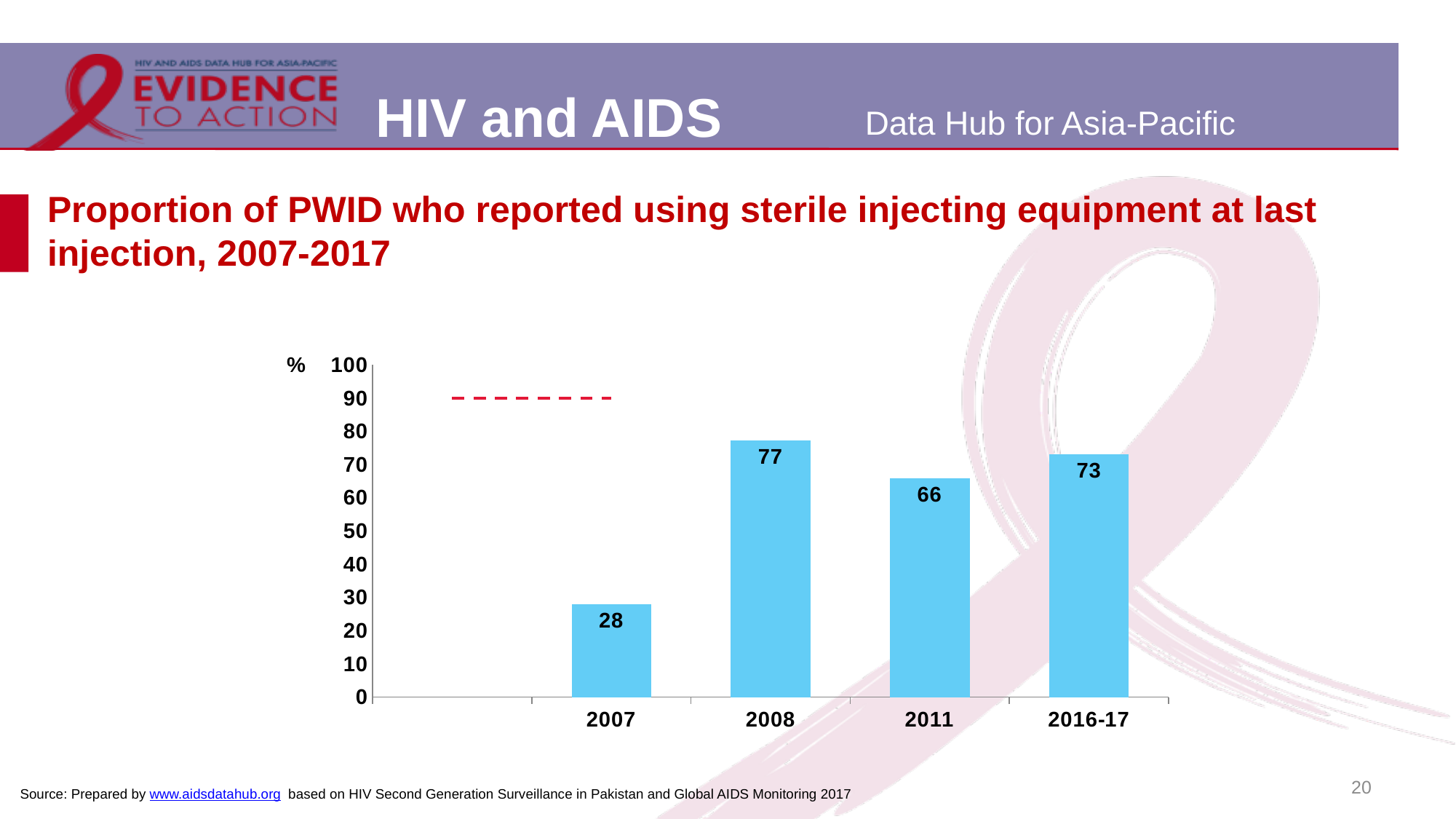
What is the unit shown on the y axis of the chart? % Which is larger, the value for 2011 or the value for 2016-17? 2016-17 What is the value for 2016-17? 73 Which year has the highest value? 2008 What is the value for 2008? 77 What is the difference between the values for 2008 and 2007? 49 What is the value for 2007? 28 What is the value for 2011? 66 What is the difference between the values for 2016-17 and 2011? 7 Which year has the lowest value? 2007 How many bars are shown in the chart? 4 What kind of chart is shown on the slide? Bar chart